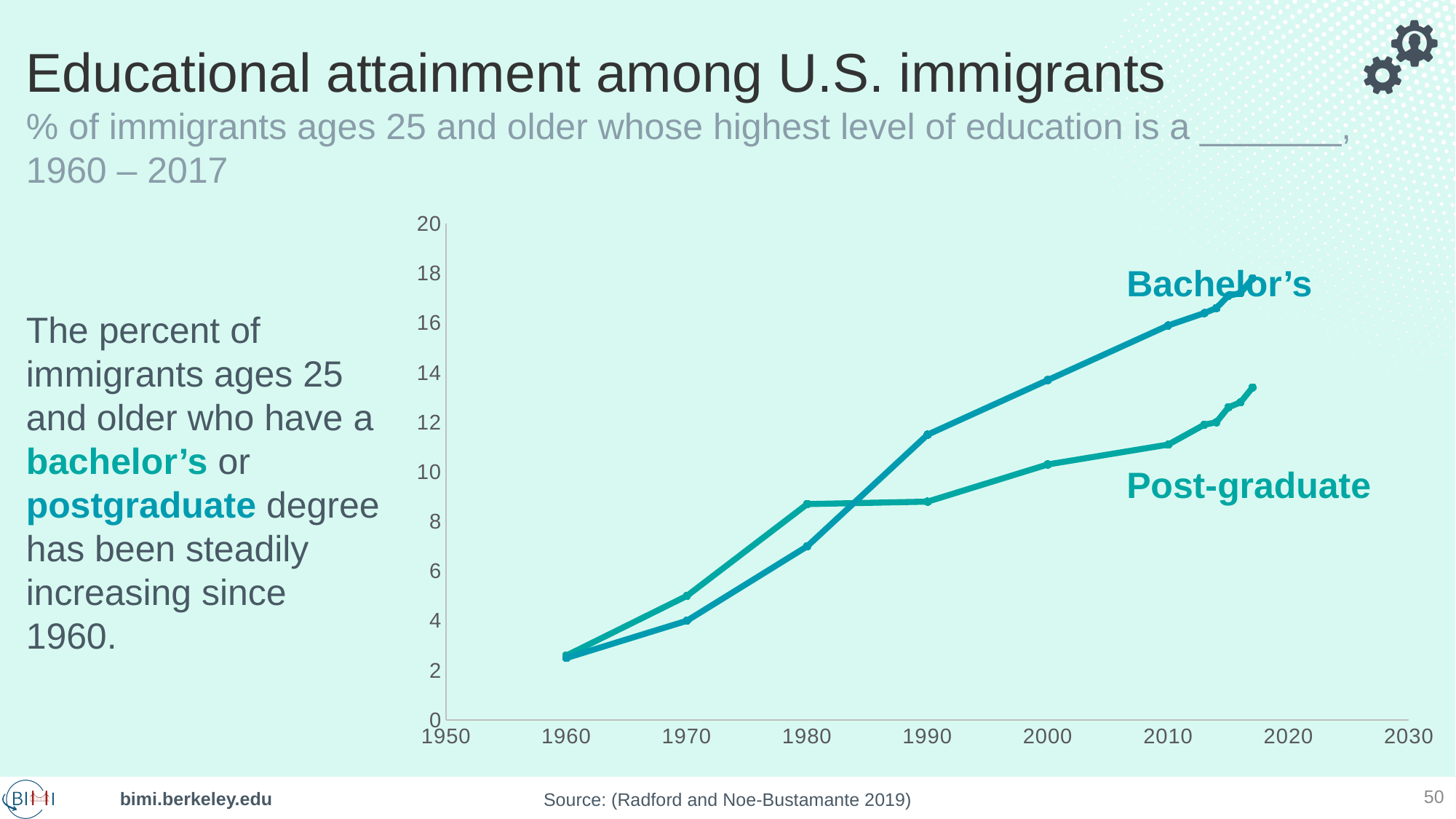
What is the title of the slide containing the chart? Educational attainment among U.S. immigrants Is the Bachelor's value in 1980 greater or less than 8? less Is the Bachelor's value in 1990 greater or less than 10? greater Is the Post-graduate value in 2000 greater or less than 12? less Which series has the highest value at the end of the chart (2017)? Bachelor's In 2010, which series has the higher value, Bachelor's or Post-graduate? Bachelor's What kind of chart is shown on the slide? line chart Does the Bachelor's line rise or fall from 1960 to 2017? rise How many series are plotted on the chart? 2 In 1970, which series has the higher value, Bachelor's or Post-graduate? Post-graduate